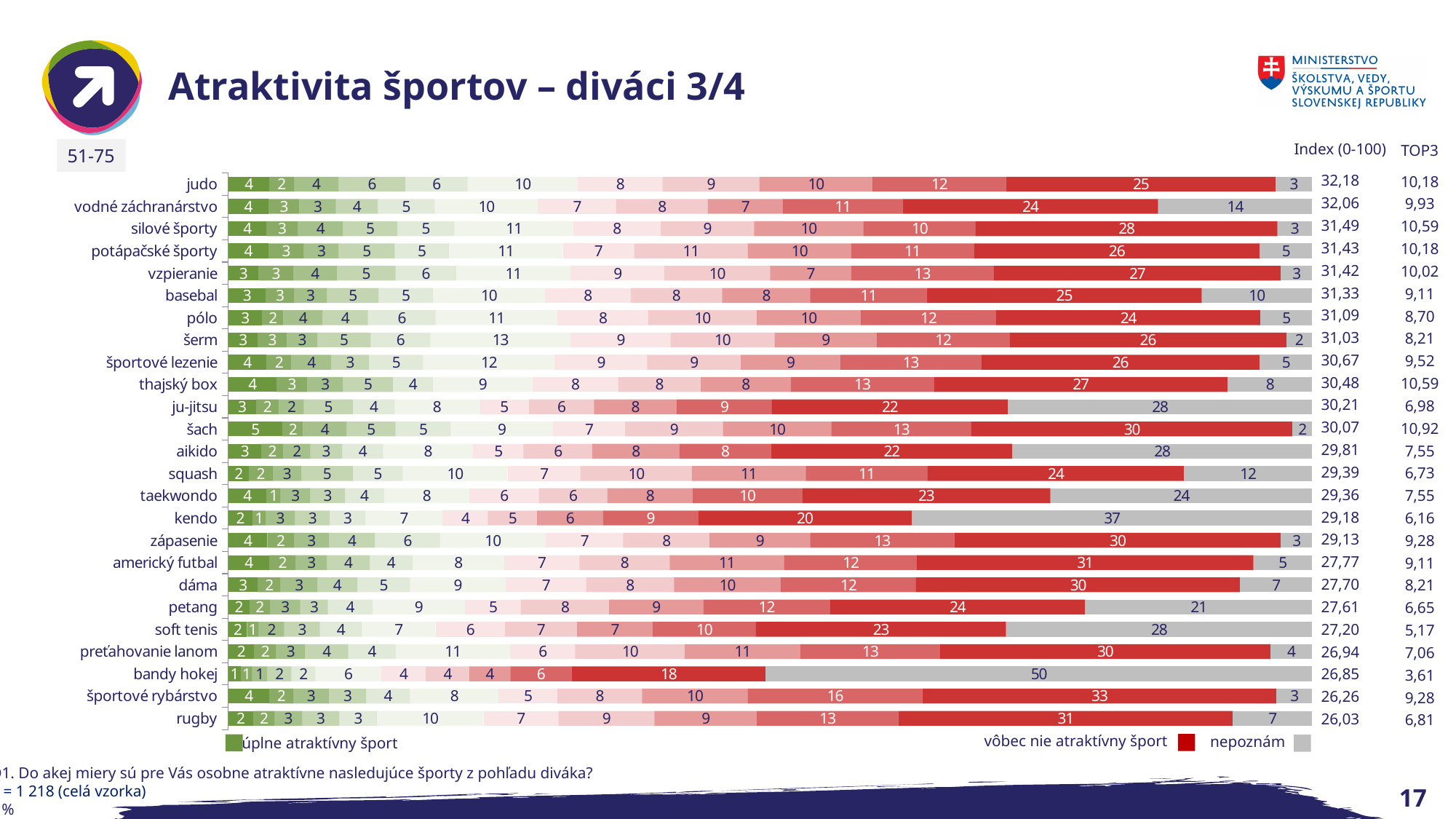
What is the TOP3 value for šach? 10,92 Which sport has the lowest TOP3 value? bandy hokej Which sport has the largest 'nepoznám' segment? bandy hokej Which has a larger 'nepoznám' segment, ju-jitsu or squash? ju-jitsu What is the Index (0-100) value for judo? 32,18 How many sports are listed in the chart? 25 What is the difference between the 'nepoznám' segment for vodné záchranárstvo and for judo? 11 What is the value of the grey 'nepoznám' segment for kendo? 37 Which sport has the lowest Index (0-100) value? rugby What is the value of the grey 'nepoznám' segment for bandy hokej? 50 What kind of chart is shown on the slide? bar chart What is the title of the slide's chart? Atraktivita športov – diváci 3/4